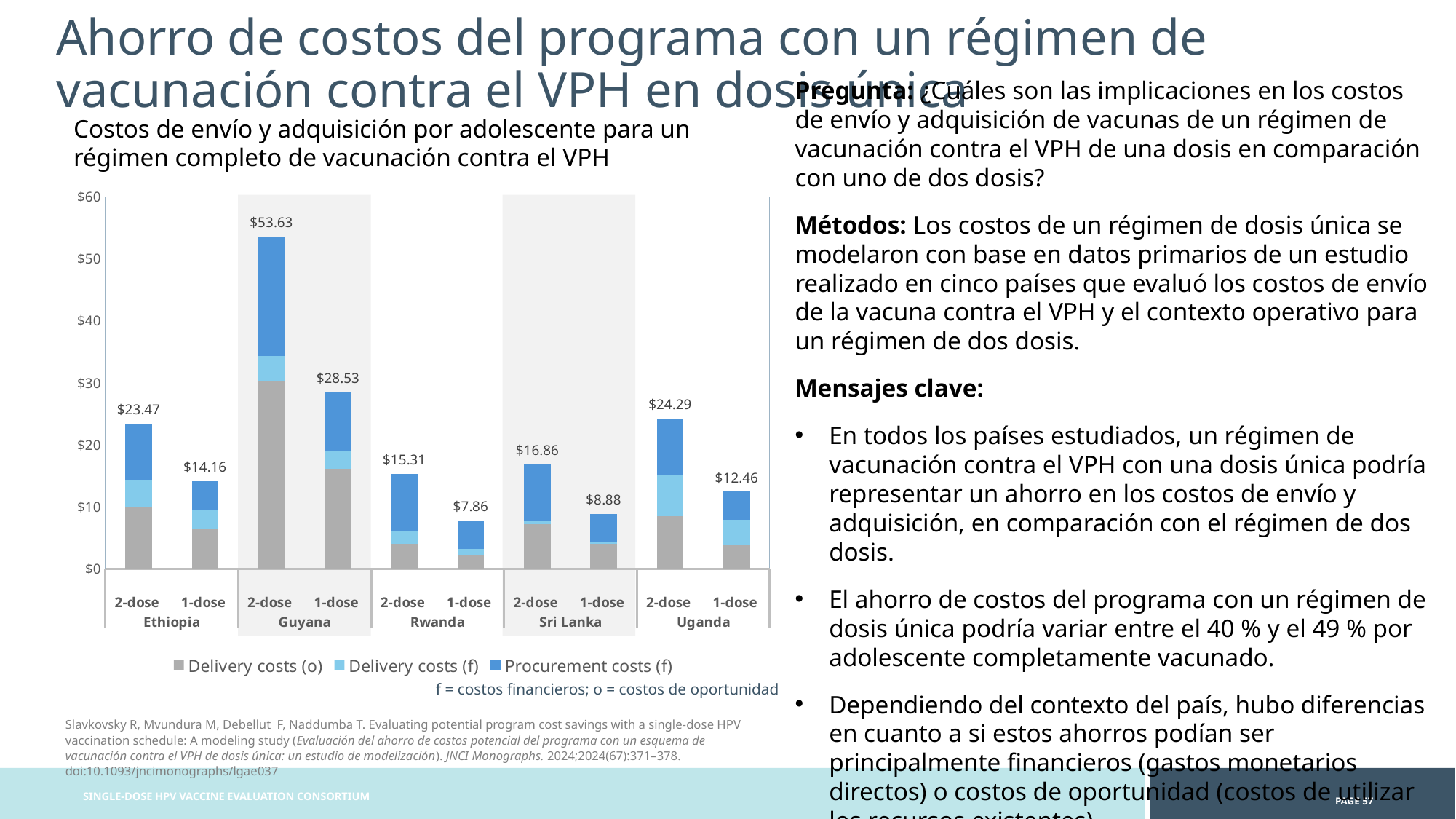
What is the total cost per adolescent for the 1-dose regimen in Uganda? $12.46 How many countries are shown on the x axis? 5 How many series does the legend list? 3 Which bar has the highest total cost? Guyana 2-dose What is the difference between the 2-dose and 1-dose total costs in Ethiopia? $9.31 What is the total cost per adolescent for the 2-dose regimen in Guyana? $53.63 What type of chart is shown on the slide? stacked bar chart Which is larger, the 2-dose total cost in Uganda or the 2-dose total cost in Ethiopia? Uganda 2-dose Which bar has the lowest total cost? Rwanda 1-dose Is the Delivery costs (o) value for the Guyana 1-dose bar greater or less than $10? greater What is the total cost per adolescent for the 1-dose regimen in Rwanda? $7.86 What is the difference between the 2-dose and 1-dose total costs in Guyana? $25.10